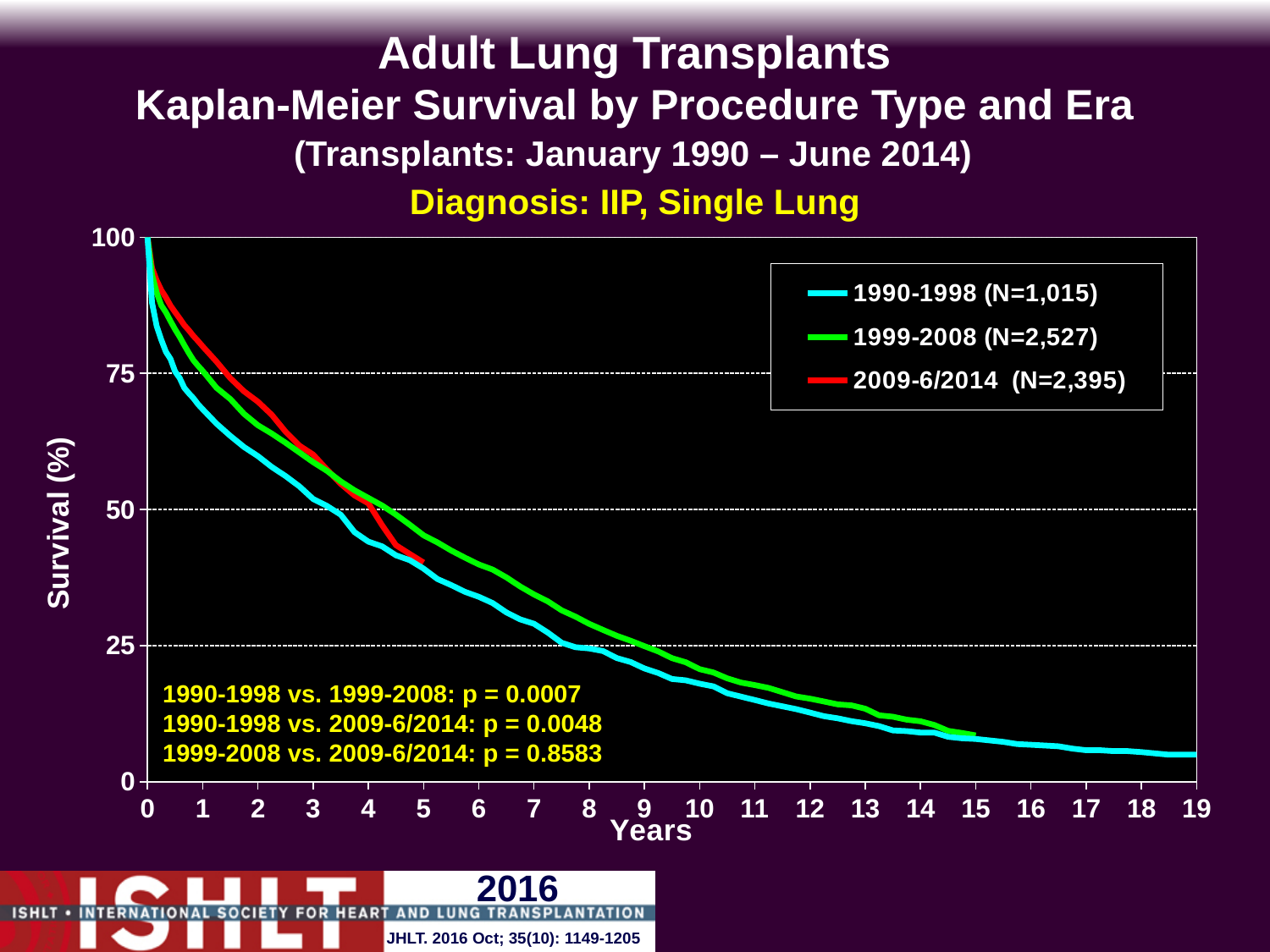
What is the N for the 1999-2008 era in the legend? 2,527 Is the survival for the 2009-6/2014 era at 1 year greater or less than 75? greater What is the p-value for 1999-2008 vs. 2009-6/2014? 0.8583 Is the survival for the 1990-1998 era at 5 years greater or less than 50? less What kind of chart is shown on the slide? line chart At 10 years, which era has higher survival, 1990-1998 or 1999-2008? 1999-2008 How many series does the legend list? 3 Which era has the largest number of transplants (N) in the legend? 1999-2008 (N=2,527) What is the p-value for 1990-1998 vs. 1999-2008? 0.0007 Which era has the smallest number of transplants (N) in the legend? 1990-1998 (N=1,015) Do the survival curves rise or fall as years increase? fall What is the N for the 2009-6/2014 era in the legend? 2,395